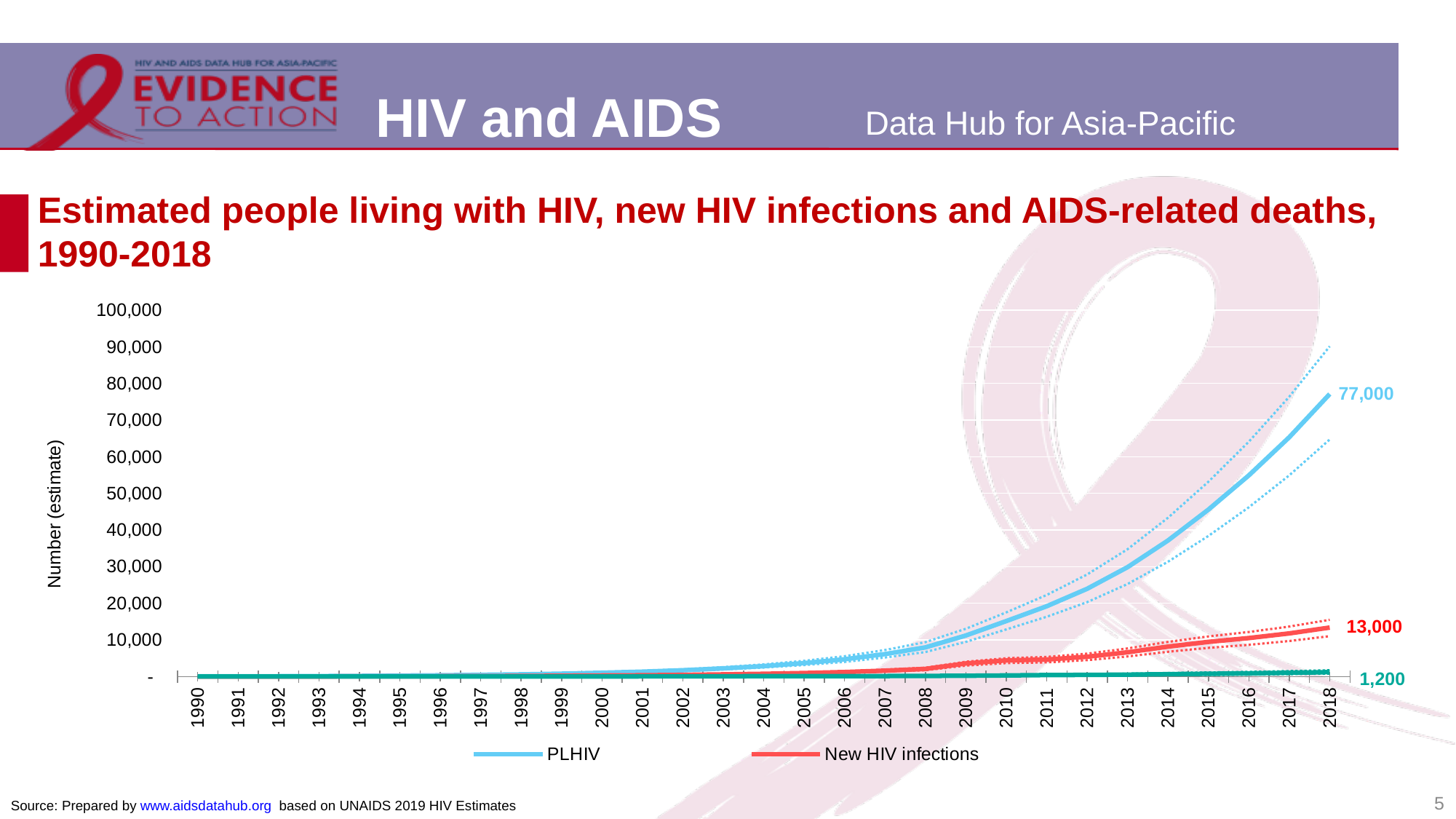
What kind of chart is shown on the slide? line chart In 2018, which is larger: PLHIV or new HIV infections? PLHIV What is the estimated number of new HIV infections in 2018? 13,000 Which series has the highest value in 2018? PLHIV Is the PLHIV value for 2016 greater or less than 40,000? greater Is the PLHIV value for 2010 greater or less than 30,000? less How many series does the legend list? 2 What is the estimated number of PLHIV in 2018? 77,000 What is the difference between the 2018 values for PLHIV and new HIV infections? 64,000 What is the label on the vertical axis? Number (estimate) What value is labelled at the end of the green line in 2018? 1,200 Does the PLHIV line rise or fall from 1990 to 2018? rise